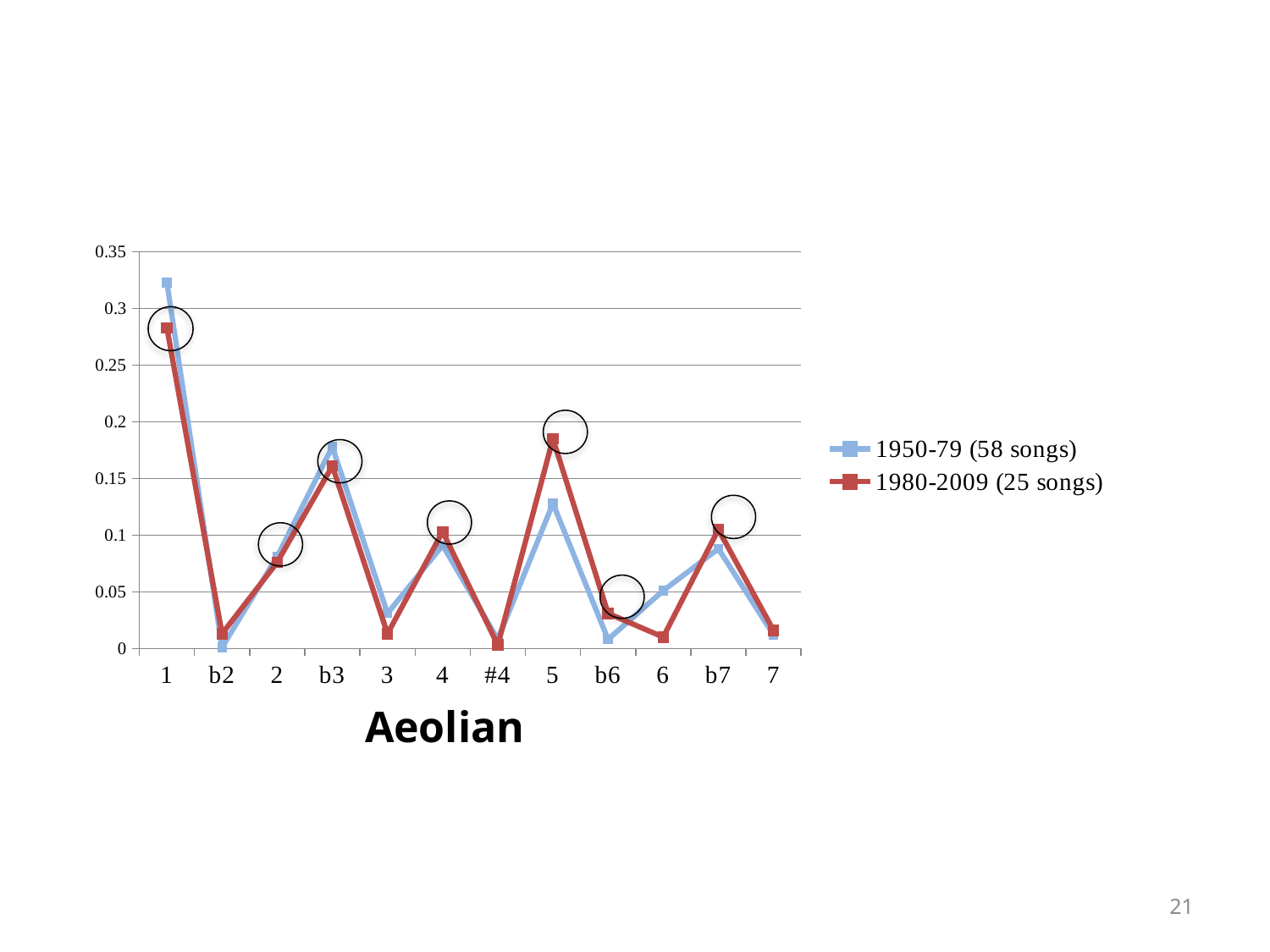
Is the value for the 1980-2009 series at category 5 greater or less than 0.15? greater How many series does the legend list? 2 What is the title of the chart? Aeolian Is the value for the 1950-79 series at category 5 greater or less than 0.15? less Which series does the legend say covers 25 songs? 1980-2009 (25 songs) What kind of chart is shown on the slide? line chart For the 1950-79 series, which category has the highest value? 1 For the 1980-2009 series, which category has the highest value? 1 At category 5, which series has the larger value, 1950-79 or 1980-2009? 1980-2009 Is the value for the 1950-79 series at category 1 greater or less than 0.3? greater At category 1, which series has the larger value, 1950-79 or 1980-2009? 1950-79 How many categories are shown along the x axis? 12